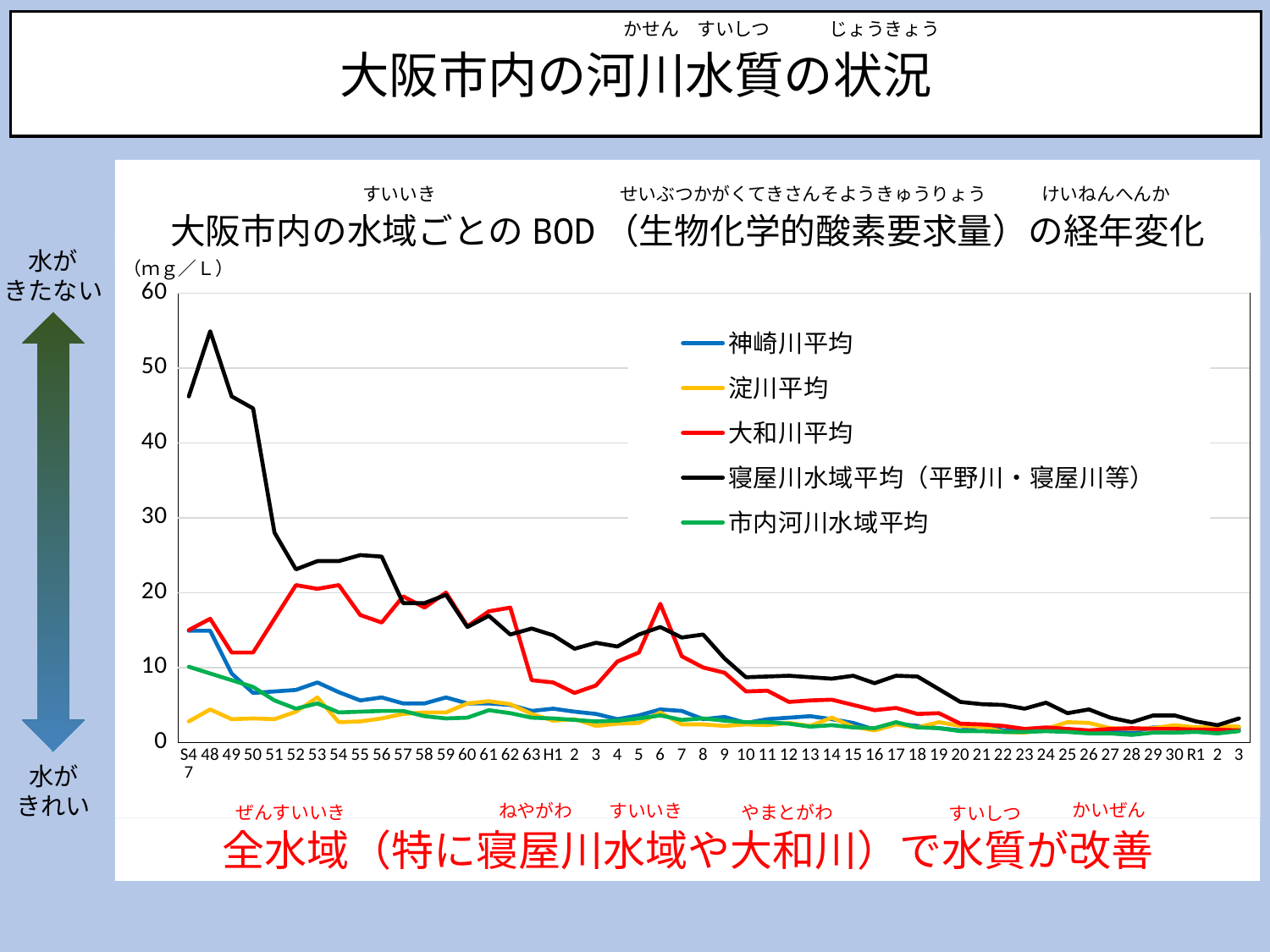
How many series does the legend list? 5 What kind of chart is shown on the slide? Line chart Is the value for 寝屋川水域平均 at 48 greater or less than 50? greater Is the value for 大和川平均 at H6 greater or less than 10? greater Does the 寝屋川水域平均 line generally rise or fall from S47 to R3? fall Is the value for 寝屋川水域平均 at 51 greater or less than 20? greater What colour is the 大和川平均 line in the legend? Red Which series has the highest value at 48 (S48)? 寝屋川水域平均（平野川・寝屋川等） At 48, which is larger: 寝屋川水域平均 or 神崎川平均? 寝屋川水域平均 Which series has the lowest value at S47? 淀川平均 What unit is shown on the y axis? mg／L